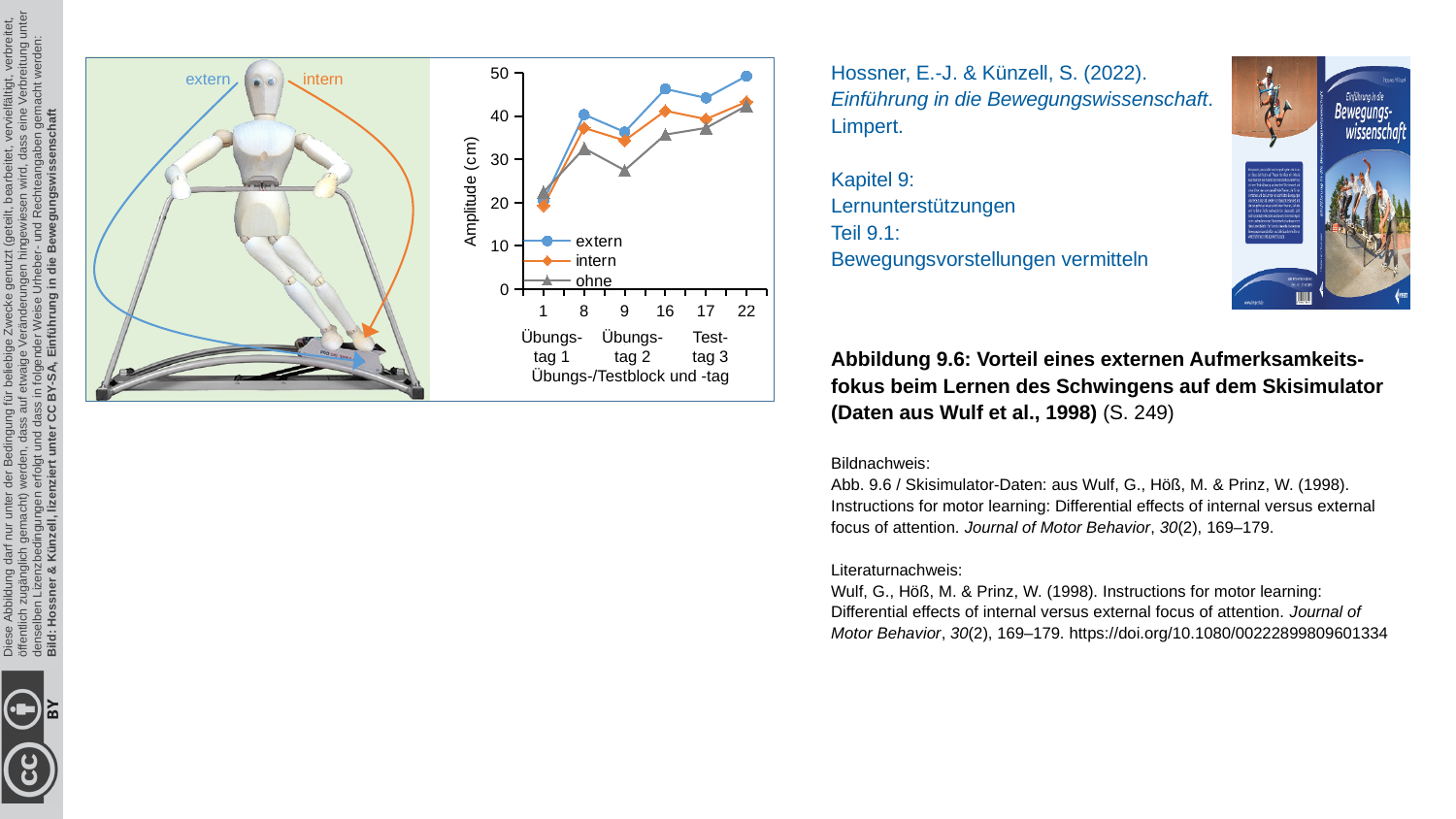
Is the value for intern at block 8 greater or less than 30? greater Does the extern series rise or fall from block 1 to block 8? rise What is the label of the x axis? Übungs-/Testblock und -tag What kind of chart is shown on the slide? line chart Is the value for extern at block 22 greater or less than 40? greater At block 22, which series has the higher value, extern or ohne? extern How many series does the chart legend list? 3 Is the value for ohne at block 1 greater or less than 30? less Which series has the lowest value at block 9? ohne How many x-axis points (blocks) are plotted for each series? 6 What is the label of the y axis? Amplitude (cm)